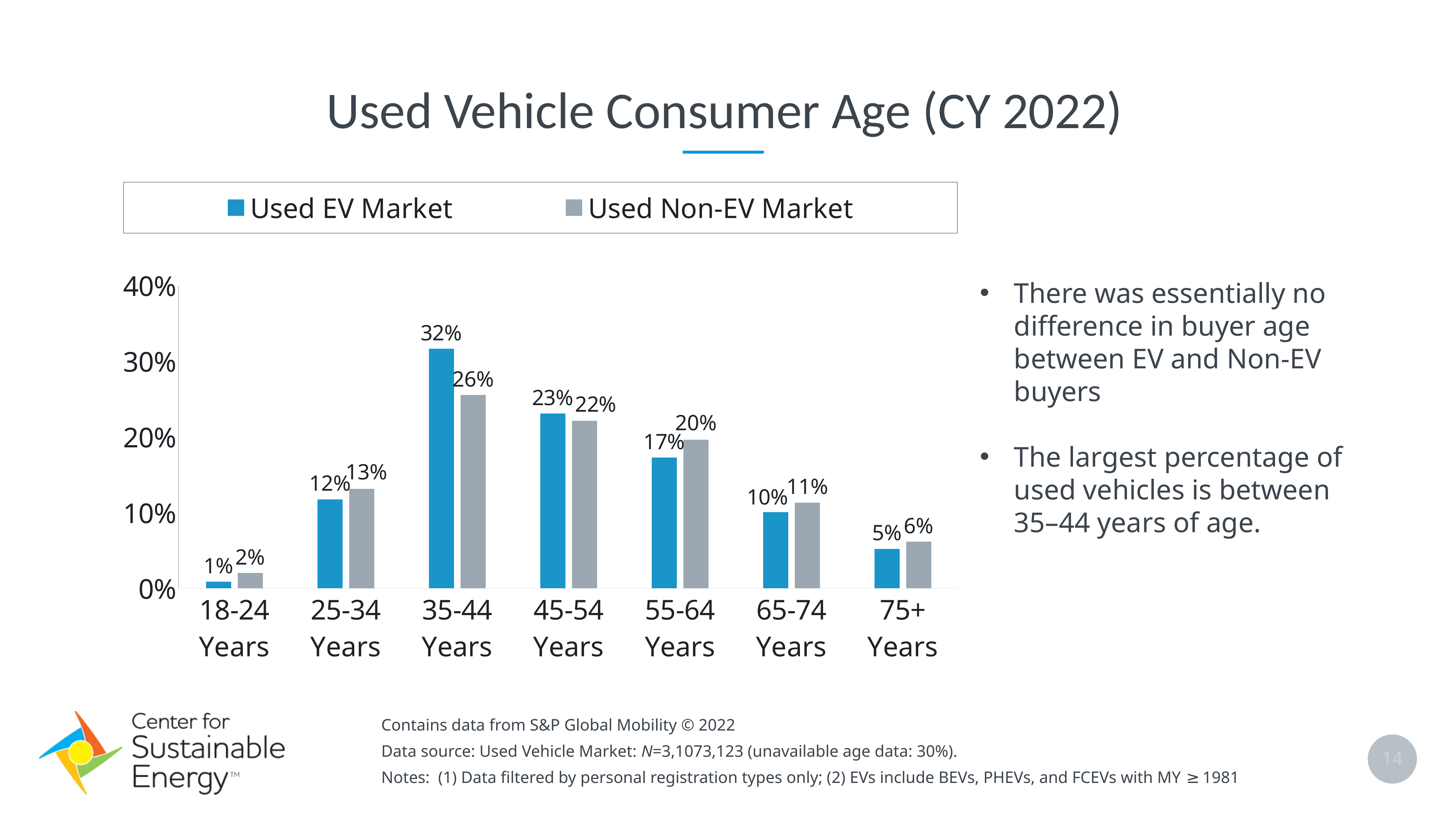
How many age groups are shown on the x axis? 7 What is the Used Non-EV Market value for 55-64 Years? 20% Which age group has the lowest Used Non-EV Market value? 18-24 Years What is the difference between the Used EV Market and Used Non-EV Market values for 35-44 Years? 6% Which is larger for 55-64 Years: the Used EV Market value or the Used Non-EV Market value? Used Non-EV Market What is the title of the chart? Used Vehicle Consumer Age (CY 2022) What is the Used EV Market value for 18-24 Years? 1% Is the Used EV Market value for 45-54 Years greater or less than 20%? greater What kind of chart is shown on the slide? bar chart Which age group has the highest Used EV Market value? 35-44 Years What is the Used EV Market value for 35-44 Years? 32% How many series does the legend list? 2